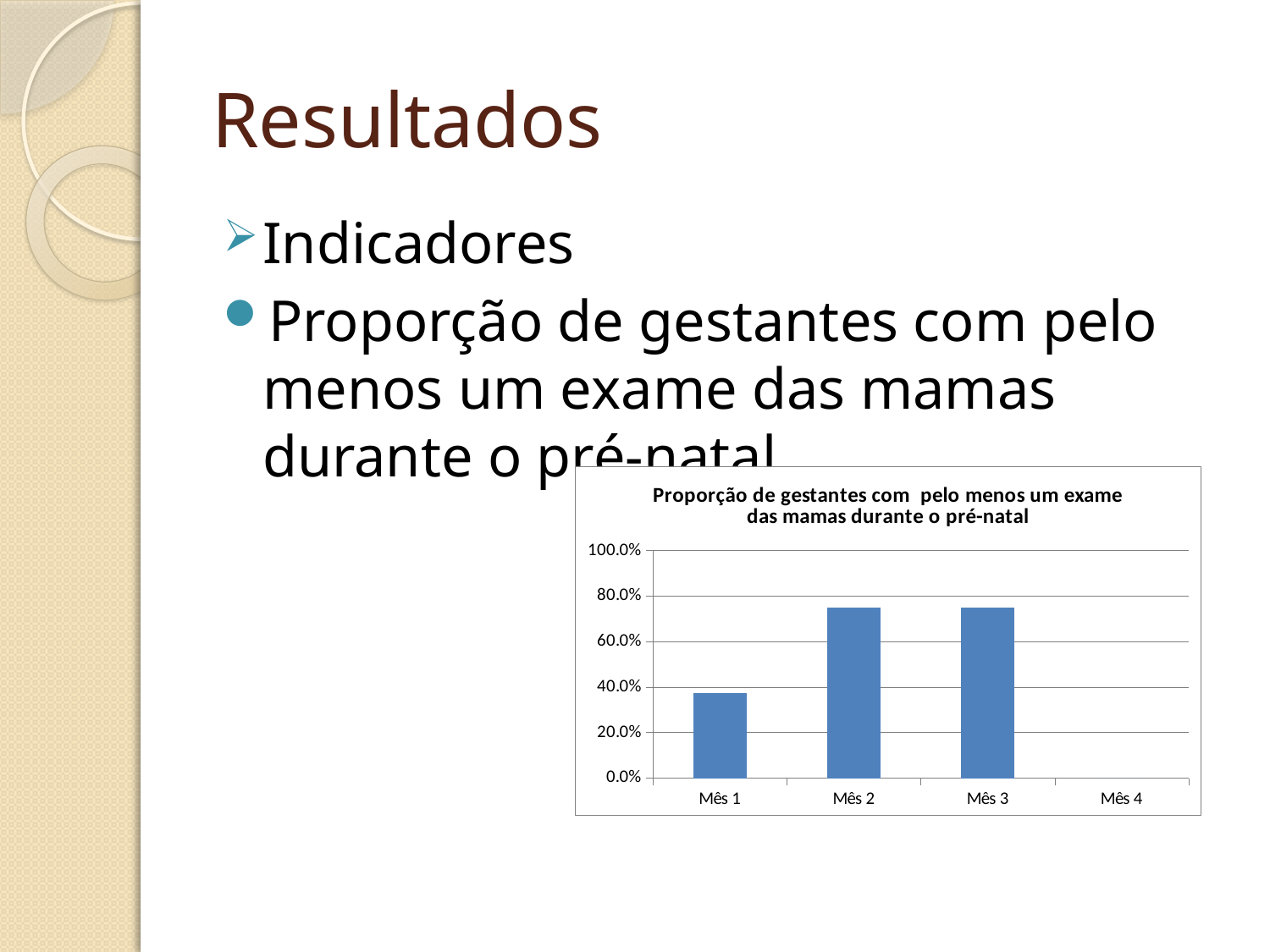
Which category has the lowest value in the chart? Mês 4 What kind of chart is shown on the slide? bar chart Is the value for Mês 2 greater or less than 60.0%? greater Is the value for Mês 1 greater or less than 20.0%? greater Does the value rise or fall from Mês 1 to Mês 2? rise Is the value for Mês 2 greater or less than 80.0%? less Which is larger, the value for Mês 1 or the value for Mês 2? Mês 2 What is the title of the chart? Proporção de gestantes com pelo menos um exame das mamas durante o pré-natal How many categories are shown on the x axis of the chart? 4 What colour are the bars in the chart? blue